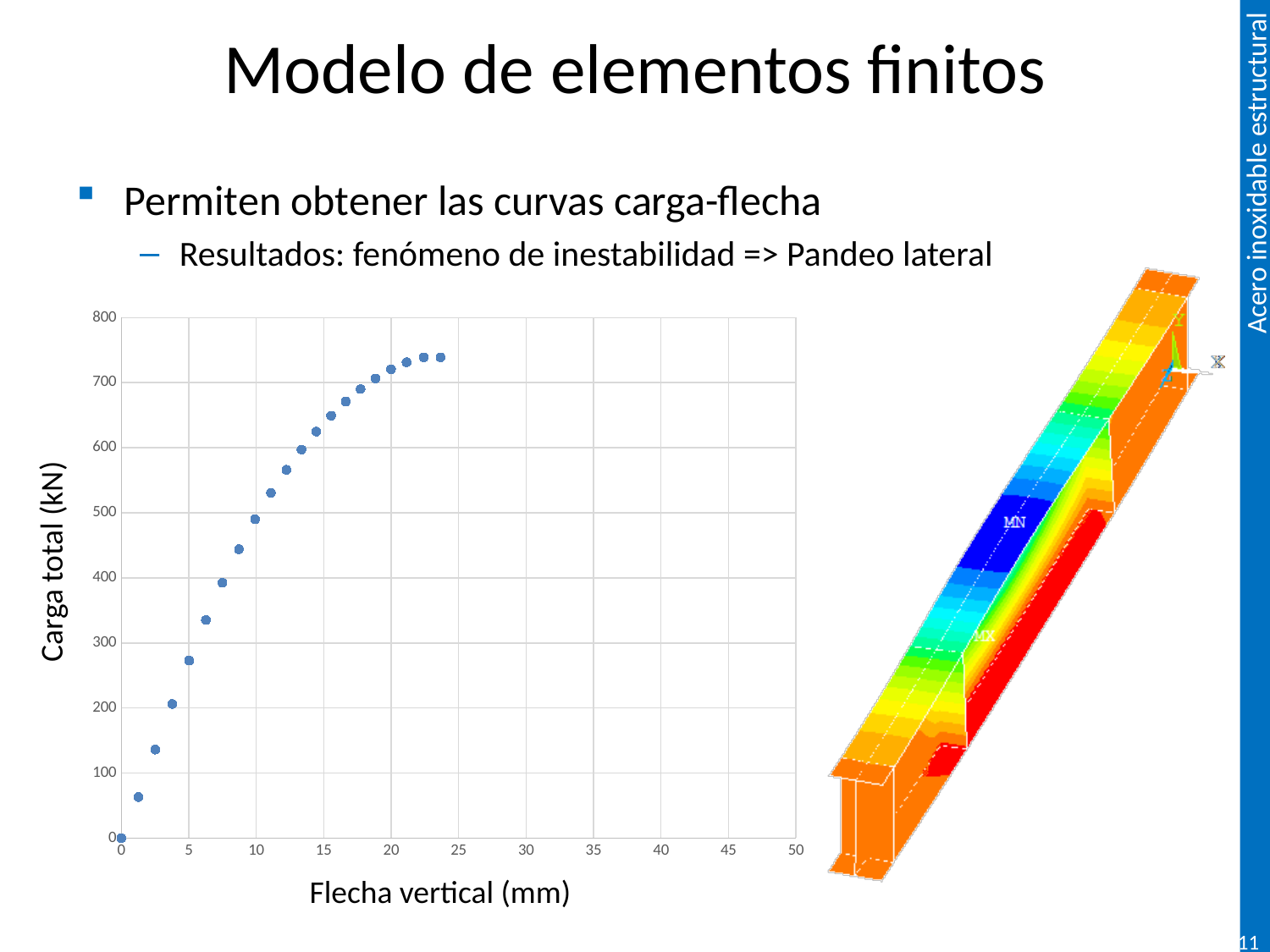
Is the largest vertical deflection plotted greater or less than 25 mm? less Do the plotted values rise or fall as the vertical deflection (Flecha vertical) increases? rise Is the highest plotted load value greater or less than 700 kN? greater Is the highest plotted load value greater or less than 800 kN? less What kind of chart is shown on the slide? scatter chart What is the title of the horizontal axis of the chart? Flecha vertical (mm) What is the title of the vertical axis of the chart? Carga total (kN)